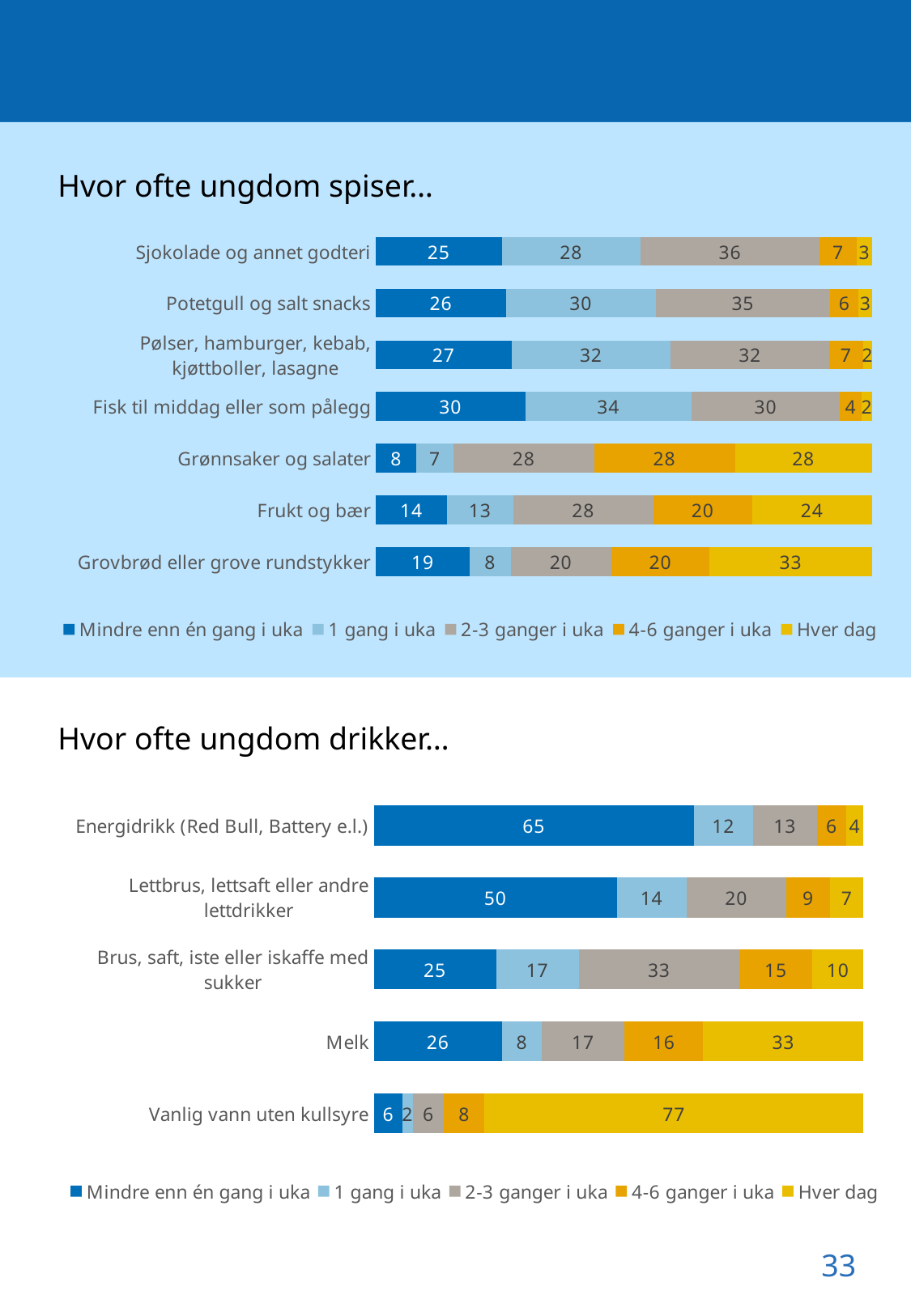
In the chart 'Hvor ofte ungdom spiser...', which category has the highest value for 'Hver dag'? Grovbrød eller grove rundstykker In the chart 'Hvor ofte ungdom drikker...', which category has the lowest value for 'Mindre enn én gang i uka'? Vanlig vann uten kullsyre In the chart 'Hvor ofte ungdom drikker...', what is the value for 'Hver dag' for 'Vanlig vann uten kullsyre'? 77 What kind of chart is 'Hvor ofte ungdom spiser...'? Stacked bar chart In the chart 'Hvor ofte ungdom spiser...', what is the value for 'Mindre enn én gang i uka' for 'Fisk til middag eller som pålegg'? 30 In the chart 'Hvor ofte ungdom spiser...', which is larger for 'Hver dag': 'Frukt og bær' or 'Grønnsaker og salater'? Grønnsaker og salater In the chart 'Hvor ofte ungdom drikker...', what is the total of the stacked bar for 'Melk'? 100 In the chart 'Hvor ofte ungdom drikker...', what is the difference between the 'Mindre enn én gang i uka' values for 'Energidrikk (Red Bull, Battery e.l.)' and 'Lettbrus, lettsaft eller andre lettdrikker'? 15 How many categories are shown in the chart 'Hvor ofte ungdom drikker...'? 5 How many series does the legend of the chart 'Hvor ofte ungdom drikker...' list? 5 In the chart 'Hvor ofte ungdom spiser...', what is the total of the stacked bar for 'Grønnsaker og salater'? 99 How many categories are shown in the chart 'Hvor ofte ungdom spiser...'? 7